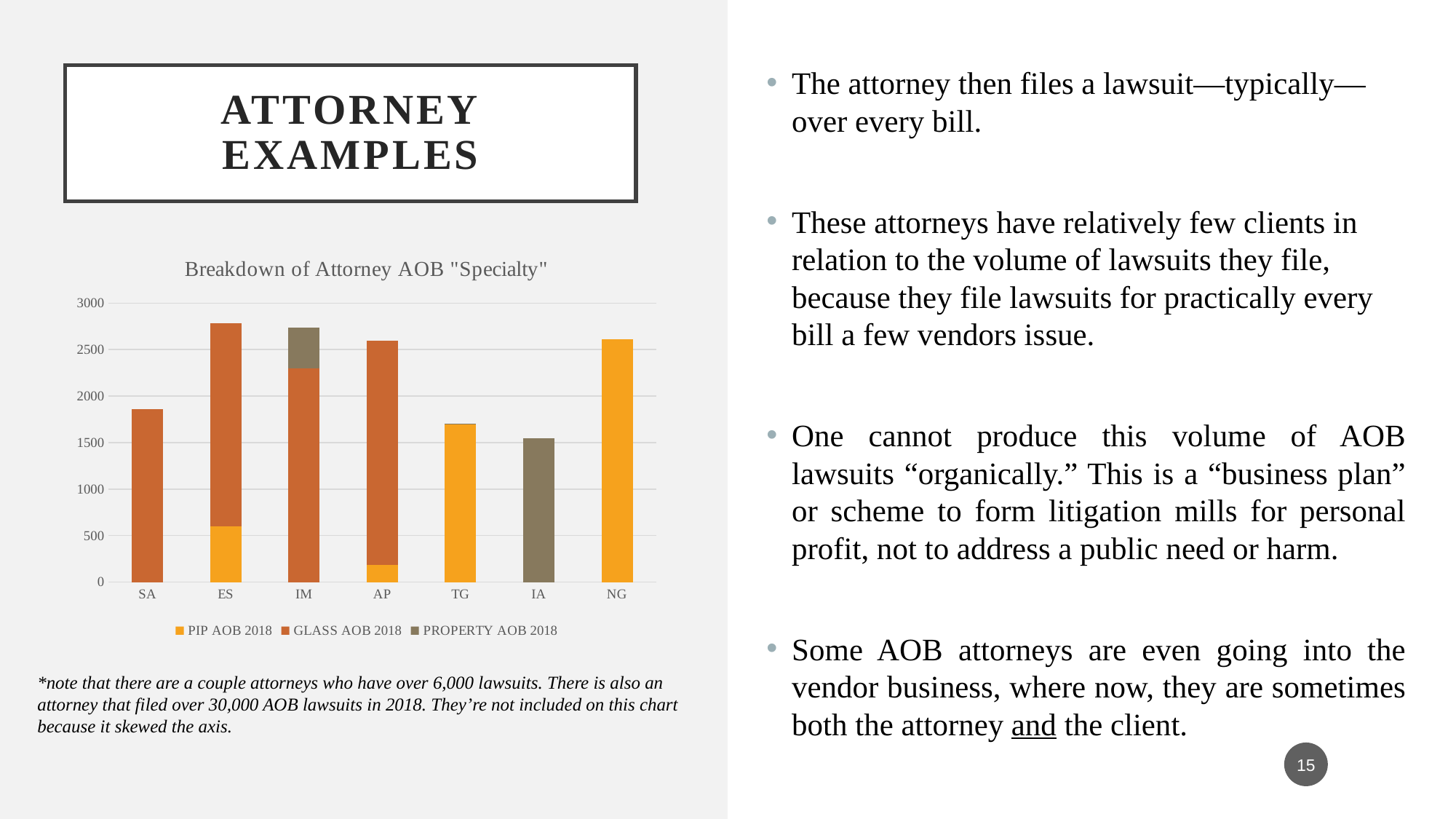
Which has the larger total bar, SA or NG? NG Which series in the legend is shown in orange-yellow? PIP AOB 2018 Is the total value for IA greater or less than 2000? less Is the total value for NG greater or less than 2500? greater What is the title of the chart? Breakdown of Attorney AOB "Specialty" Which has the larger total bar, TG or IA? TG What type of chart is shown on the slide? Stacked bar chart Is the total value for ES greater or less than 2500? greater How many attorney categories are shown on the x axis of the chart? 7 Which attorney has the lowest total bar in the chart? IA How many series does the chart's legend list? 3